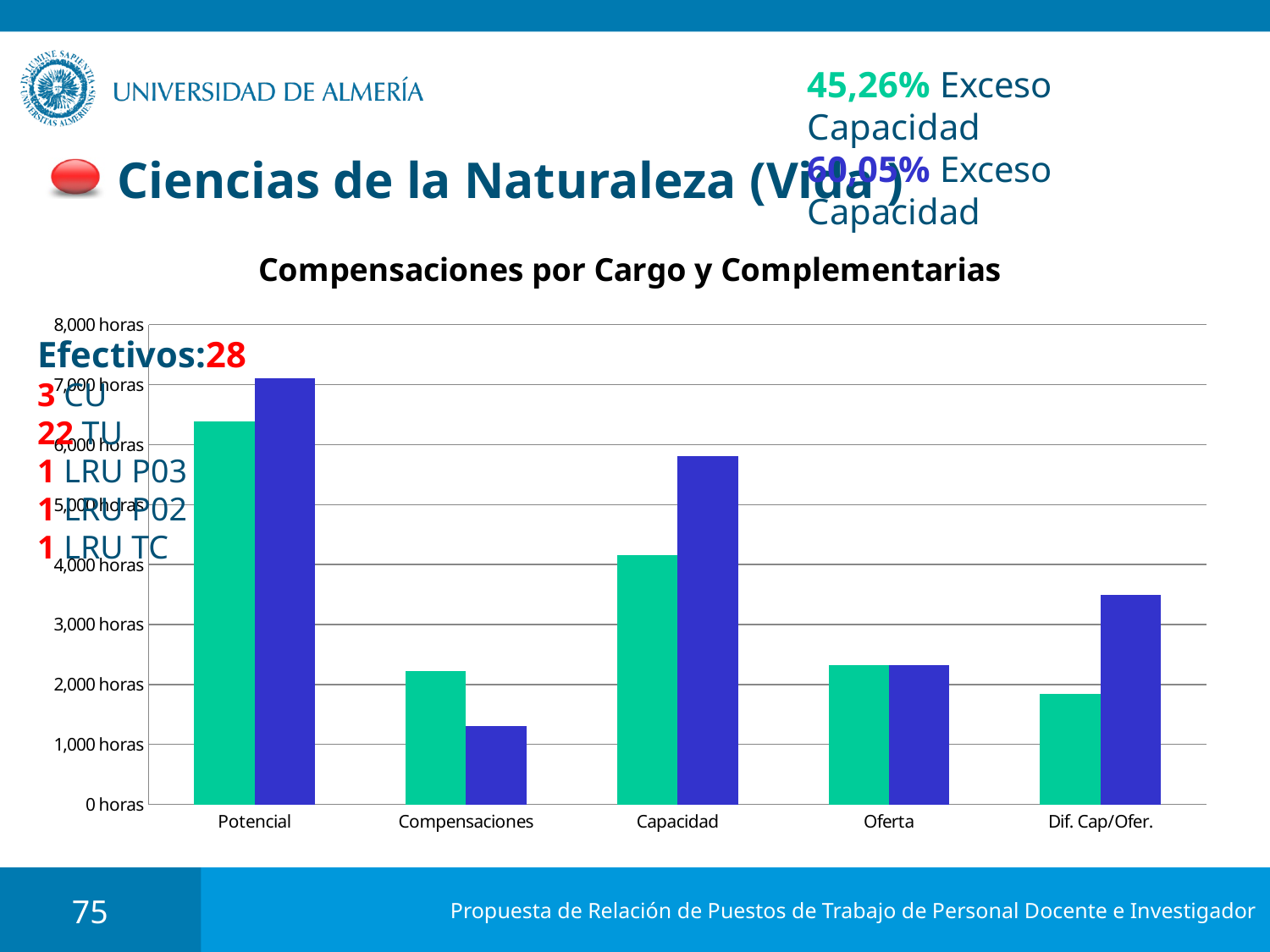
Which category has the shortest blue bar? Compensaciones For Compensaciones, which bar is taller, the green one or the blue one? the green one Which category has the tallest blue bar? Potencial What is the title of the chart? Compensaciones por Cargo y Complementarias Which category has the tallest green bar? Potencial Is the blue bar for Dif. Cap/Ofer. greater or less than 3,000 horas? greater For Capacidad, which bar is taller, the green one or the blue one? the blue one Is the blue bar for Potencial greater or less than 7,000 horas? greater How many categories are shown on the x axis of the chart? 5 What kind of chart is shown on the slide? bar chart Is the blue bar for Compensaciones greater or less than 2,000 horas? less